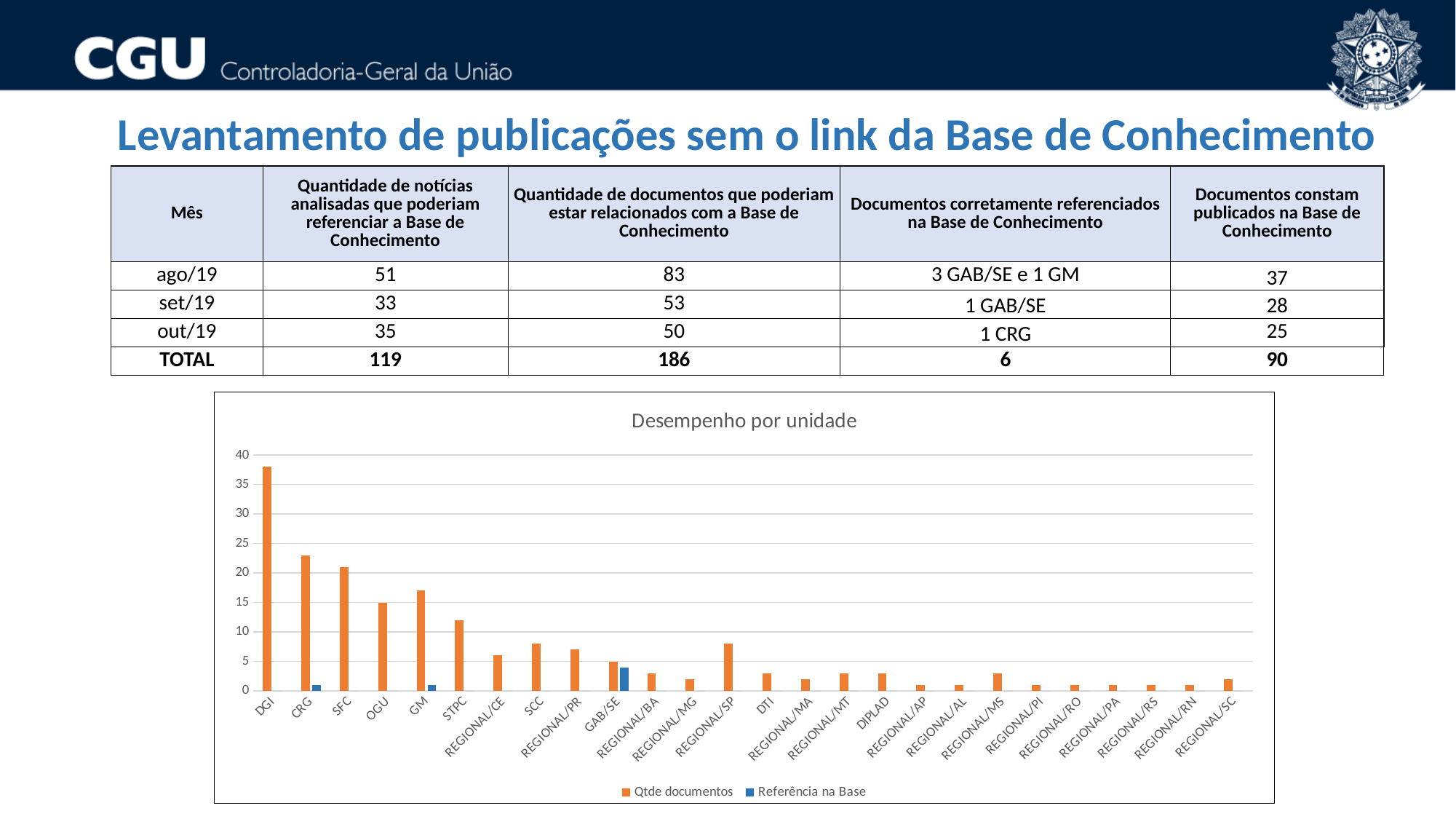
In the chart "Desempenho por unidade", is the Qtde documentos value for CRG greater or less than 20? greater How many units are shown on the x axis of the chart "Desempenho por unidade"? 26 In the chart "Desempenho por unidade", which colour represents the series Referência na Base? blue In the chart "Desempenho por unidade", is the Qtde documentos value for STPC greater or less than 15? less What type of chart is "Desempenho por unidade"? bar chart What is the title of the chart on the slide? Desempenho por unidade In the chart "Desempenho por unidade", is the Qtde documentos value for DGI greater or less than 35? greater In the chart "Desempenho por unidade", which has a larger Qtde documentos value, REGIONAL/SP or REGIONAL/MG? REGIONAL/SP How many series does the legend of the chart "Desempenho por unidade" list? 2 In the chart "Desempenho por unidade", which has a larger Qtde documentos value, SFC or OGU? SFC In the chart "Desempenho por unidade", which unit has the highest value for Qtde documentos? DGI